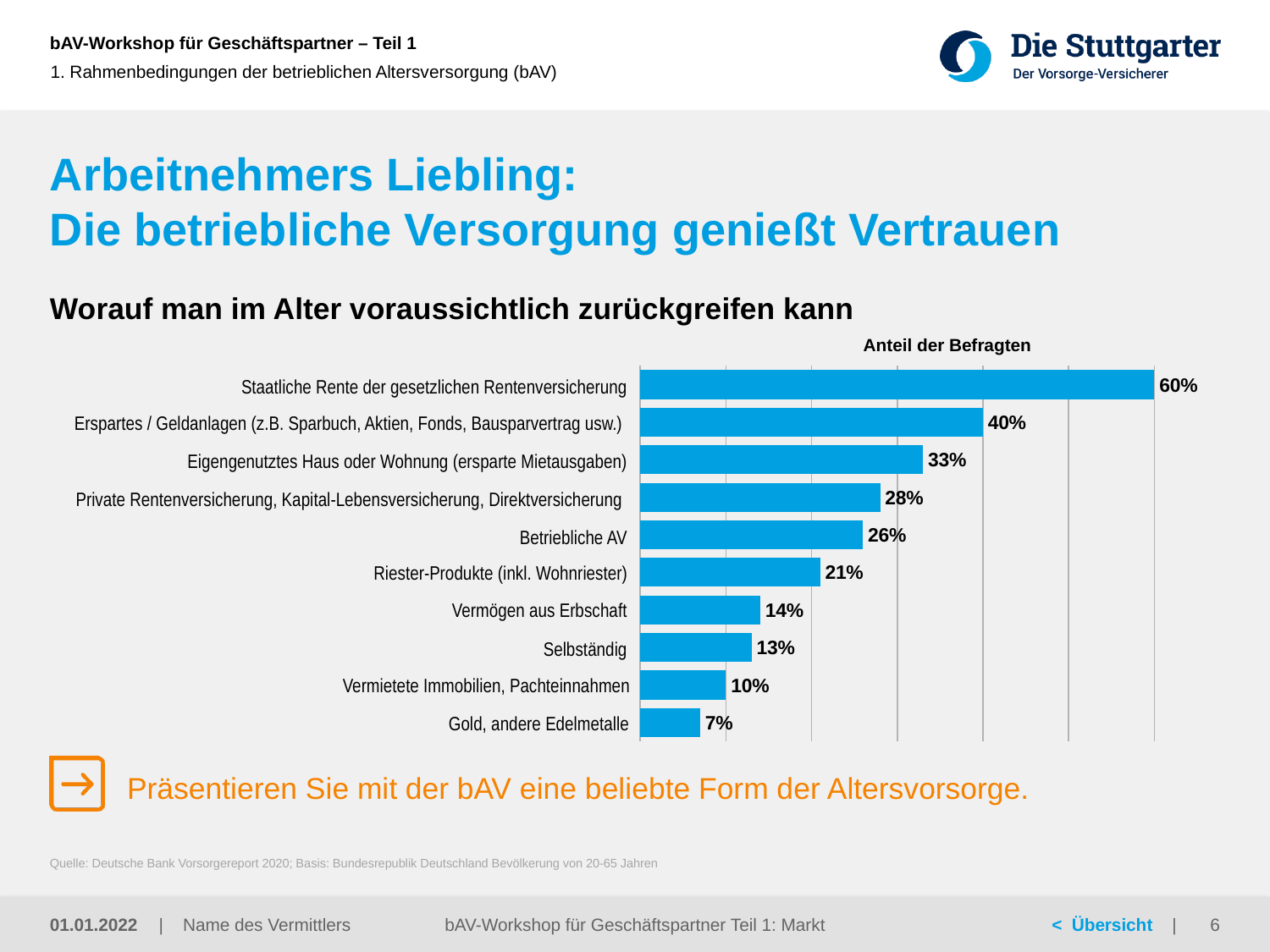
What is the label shown above the chart's bars? Anteil der Befragten What is the value for Betriebliche AV? 26% Which category has the highest value? Staatliche Rente der gesetzlichen Rentenversicherung Which is larger, the value for Eigengenutztes Haus oder Wohnung (ersparte Mietausgaben) or the value for Private Rentenversicherung, Kapital-Lebensversicherung, Direktversicherung? Eigengenutztes Haus oder Wohnung (ersparte Mietausgaben) What is the difference between the values for Vermögen aus Erbschaft and Selbständig? 1% What is the value for Riester-Produkte (inkl. Wohnriester)? 21% Which category has the lowest value? Gold, andere Edelmetalle How many categories are shown in the chart? 10 What is the value for Ersparte / Geldanlagen (z.B. Sparbuch, Aktien, Fonds, Bausparvertrag usw.)? 40% What is the difference between the values for Staatliche Rente der gesetzlichen Rentenversicherung and Betriebliche AV? 34% What kind of chart is shown on the slide? Bar chart What is the value for Vermietete Immobilien, Pachteinnahmen? 10%